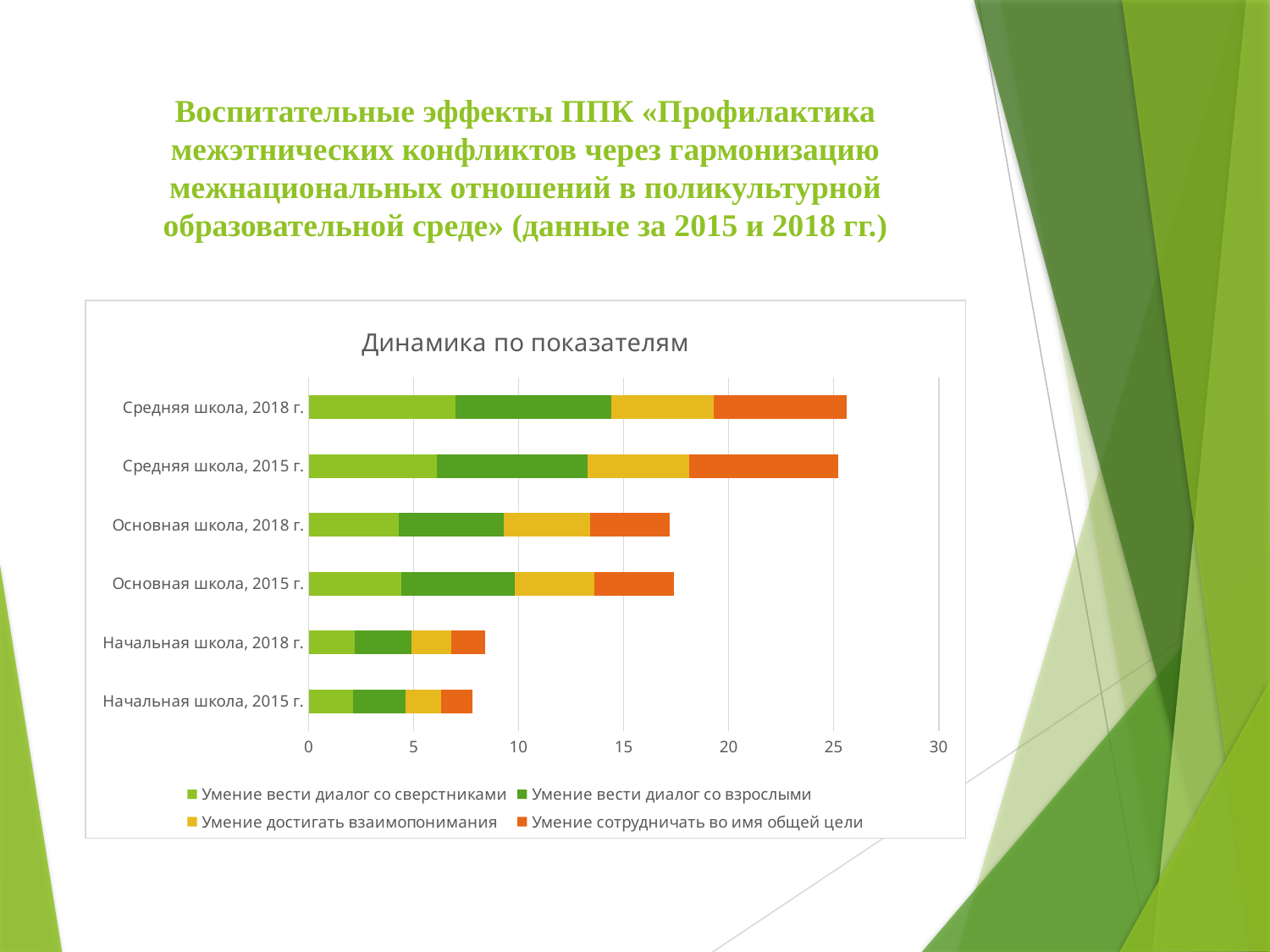
Which series is shown in orange in the legend? Умение сотрудничать во имя общей цели Is the total bar length for Начальная школа, 2015 г. greater or less than 10? less Is the total bar length for Начальная школа, 2018 г. greater or less than 5? greater Is the total bar length for Основная школа, 2015 г. greater or less than 15? greater What is the title of the chart? Динамика по показателям How many series does the chart's legend list? 4 Which has the longer total bar: Средняя школа, 2018 г. or Основная школа, 2018 г.? Средняя школа, 2018 г. Which has the longer total bar: Основная школа, 2015 г. or Начальная школа, 2015 г.? Основная школа, 2015 г. What kind of chart is shown on the slide? Stacked bar chart How many categories are shown on the chart's vertical axis? 6